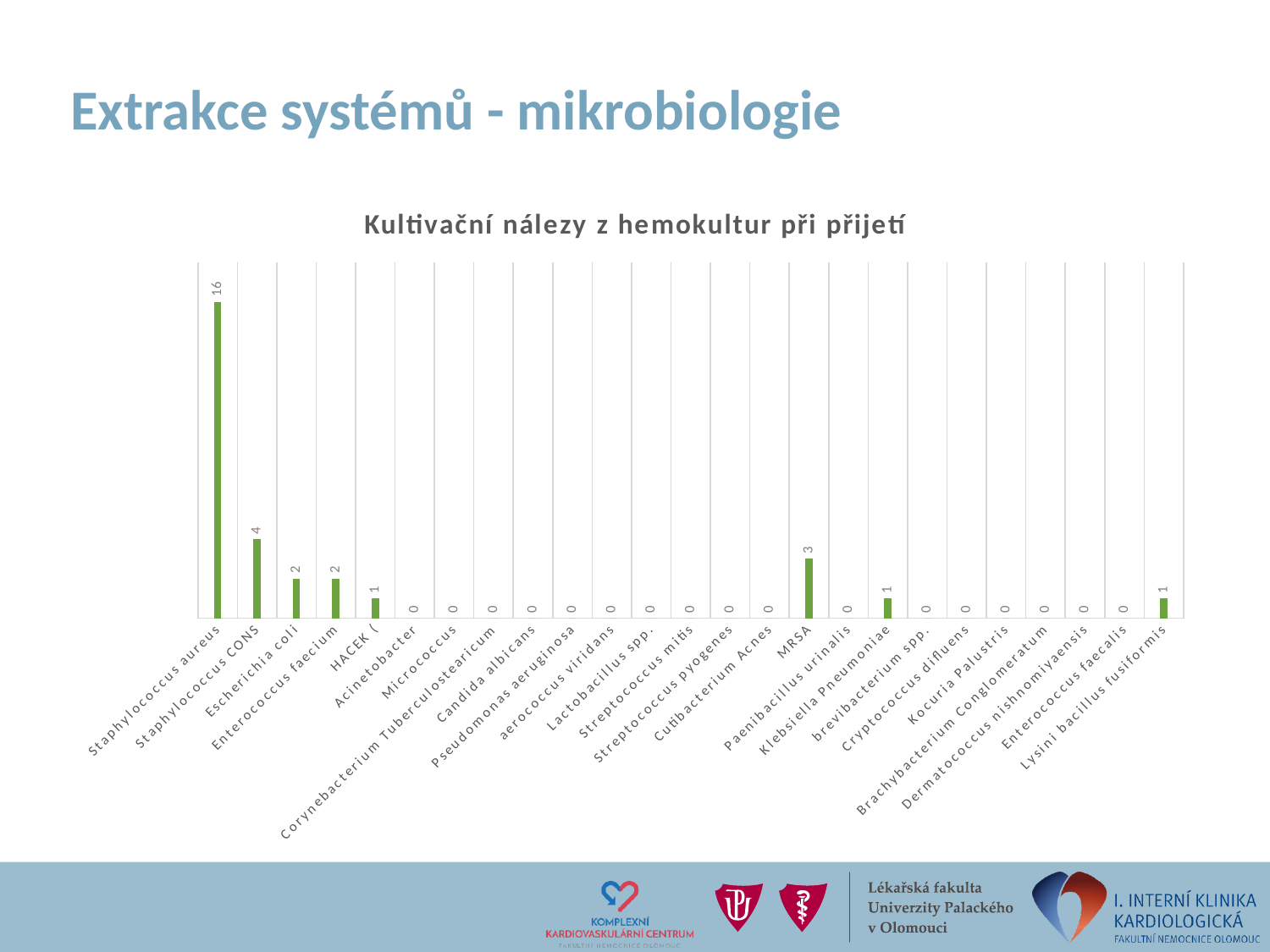
What is the value for Klebsiella Pneumoniae? 1 What is the value for MRSA? 3 What is the value for Lysini bacillus fusiformis? 1 What kind of chart is shown on the slide? Bar chart What is the value for Staphylococcus CONS? 4 Which is larger, the value for MRSA or the value for Enterococcus faecium? MRSA What is the value for Escherichia coli? 2 What is the difference between the values for Staphylococcus CONS and MRSA? 1 What is the title of the chart? Kultivační nálezy z hemokultur při přijetí What is the value for Staphylococcus aureus? 16 What is the difference between the values for Staphylococcus aureus and Staphylococcus CONS? 12 Which category has the highest value? Staphylococcus aureus